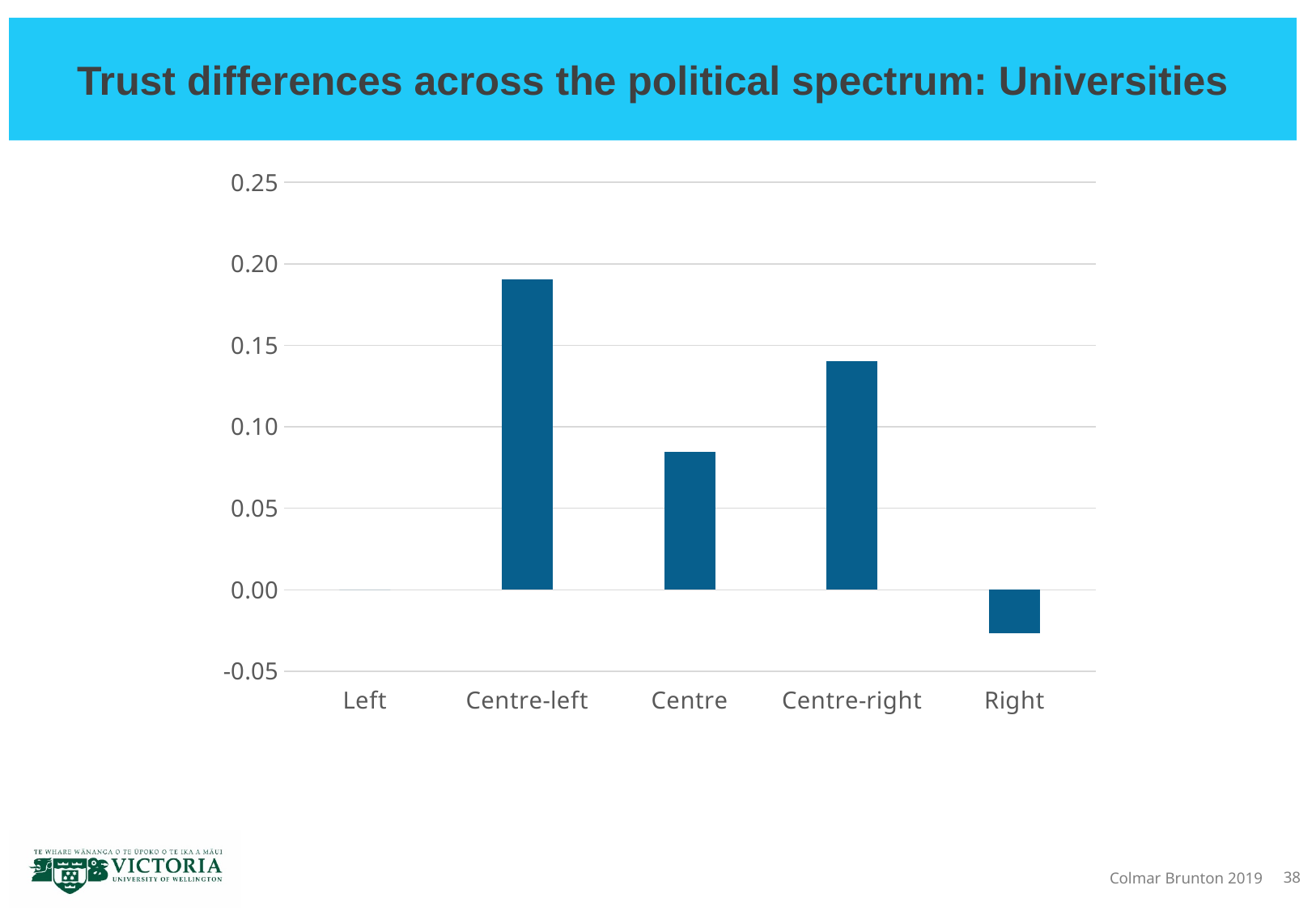
Is the value for Centre greater or less than 0.05? greater Is the value for Centre-right greater or less than 0.10? greater Which is larger, the value for Centre-left or the value for Centre-right? Centre-left Is the value for Centre greater or less than 0.10? less What is the title of the slide containing the chart? Trust differences across the political spectrum: Universities How many categories are shown on the x axis of the chart? 5 Which category has the highest value in the chart? Centre-left What kind of chart is shown on the slide? Bar chart Which is larger, the value for Centre or the value for Centre-right? Centre-right Which category has the lowest value in the chart? Right